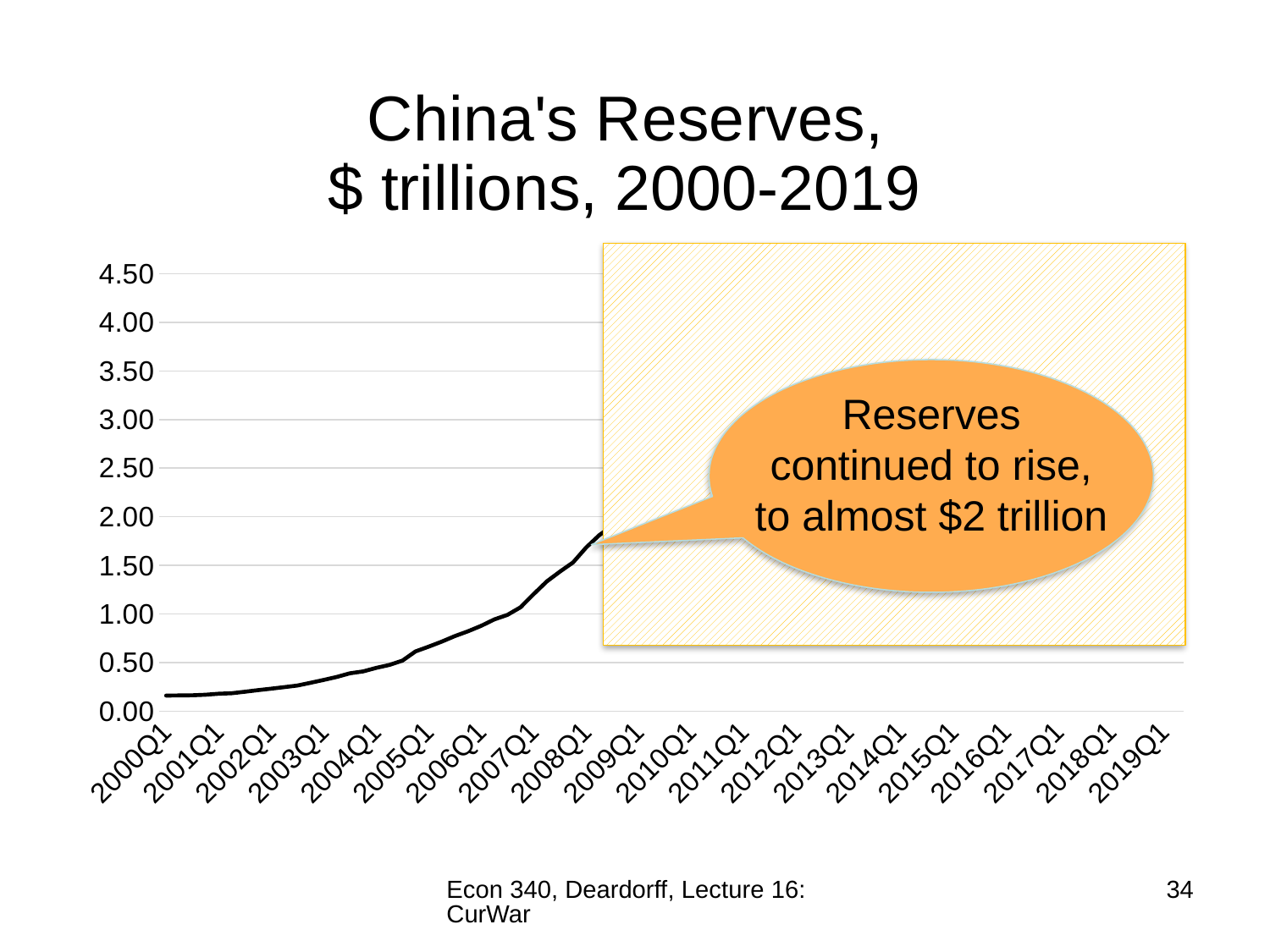
Does the plotted line for China's reserves rise or fall from 2000Q1 to 2008Q1? rise What does the callout on the chart say? Reserves continued to rise, to almost $2 trillion What kind of chart is shown on the slide? line chart How many quarter labels are shown on the x axis? 20 Which is larger, the value for 2003Q1 or the value for 2006Q1? 2006Q1 Is the value for 2003Q1 greater or less than 0.50? less What is the title of the chart? China's Reserves, $ trillions, 2000-2019 Is the value for 2006Q1 greater or less than 1.00? less Is the value for 2000Q1 greater or less than 0.50? less Which is larger, the value for 2008Q1 or the value for 2002Q1? 2008Q1